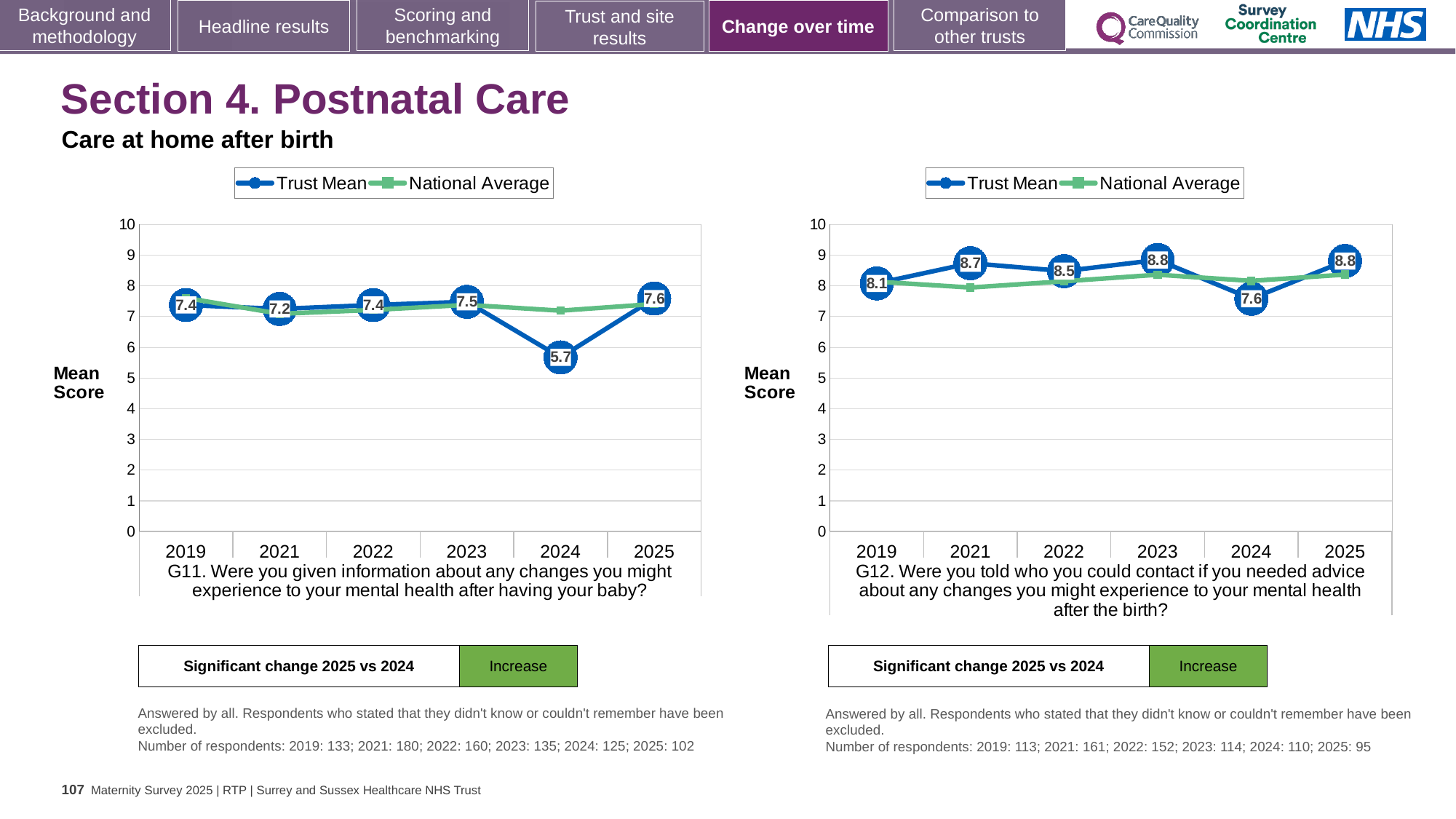
How many series does the legend of the G11 chart list? 2 In the G12 chart, what is the Trust Mean score for 2024? 7.6 In the G11 chart, what is the Trust Mean score for 2025? 7.6 In the G12 chart, which year has the lowest Trust Mean score? 2024 In the G12 chart, what is the difference between the Trust Mean scores for 2023 and 2024? 1.2 In the G11 chart, is the National Average for 2024 greater or less than 6? greater In the G11 chart, what is the difference between the Trust Mean scores for 2025 and 2024? 1.9 In the G11 chart, what is the Trust Mean score for 2024? 5.7 In the G11 chart, which year has the lowest Trust Mean score? 2024 How many years are plotted on the x axis of the G12 chart? 6 In the G12 chart, what is the Trust Mean score for 2019? 8.1 In the G12 chart, is the Trust Mean score for 2021 larger or smaller than the score for 2022? larger